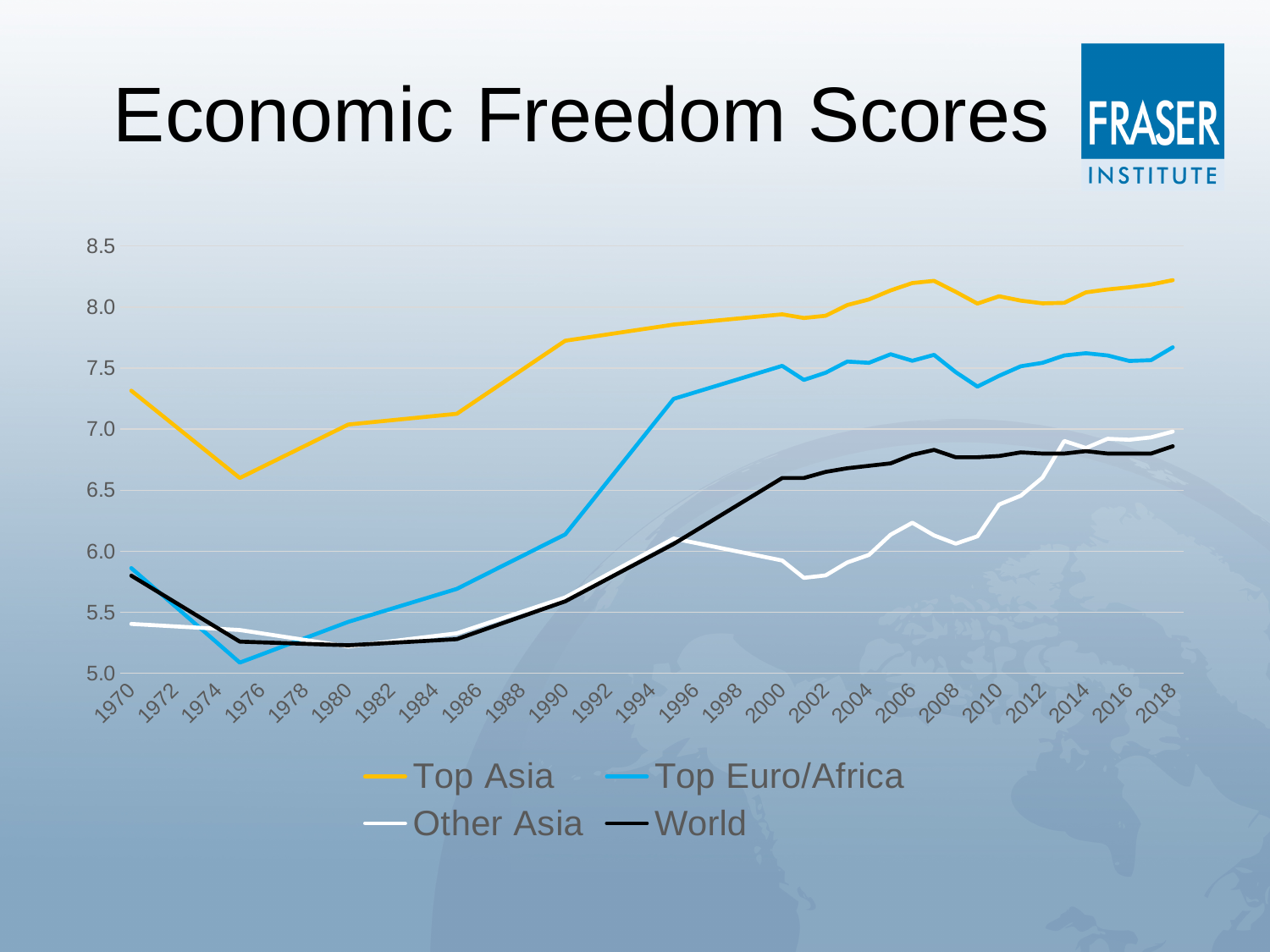
What kind of chart is shown on the slide? line chart Is the value for Top Asia in 2018 greater or less than 8.0? greater How many series does the legend list? 4 Does the Top Asia line rise or fall between 1970 and 1974? fall Is the value for Top Euro/Africa in 1976 greater or less than 5.5? less What is the title of the chart? Economic Freedom Scores Which series has the highest value in 2018? Top Asia Which series has the lowest value in 2000? Other Asia Is the value for Other Asia in 2002 greater or less than 6.0? less In 2010, which is higher: Top Euro/Africa or Other Asia? Top Euro/Africa In 1990, which is higher: Top Euro/Africa or World? Top Euro/Africa